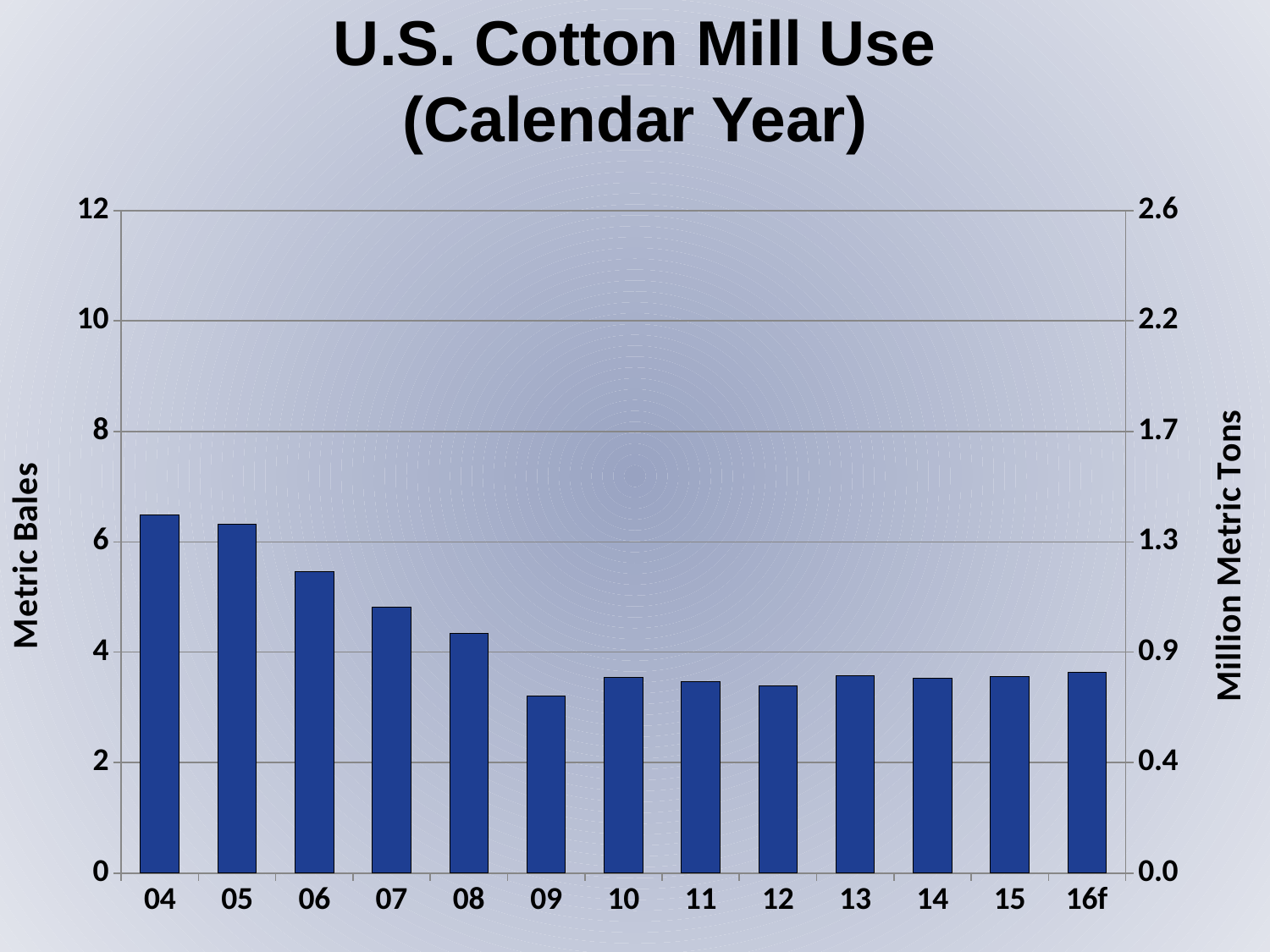
Is the value for 09 greater or less than 4 on the Metric Bales axis? less Is the value for 06 greater or less than 6 on the Metric Bales axis? less What is the label of the right-hand vertical axis? Million Metric Tons Which year has the lowest cotton mill use? 09 Which is larger, the value for 06 or the value for 08? 06 What kind of chart is shown on the slide? bar chart Which year has the highest cotton mill use? 04 What is the title of the chart? U.S. Cotton Mill Use (Calendar Year) Is the value for 08 greater or less than 4 on the Metric Bales axis? greater How many years (categories) are plotted on the x axis? 13 Do the values rise or fall from 04 to 09? fall